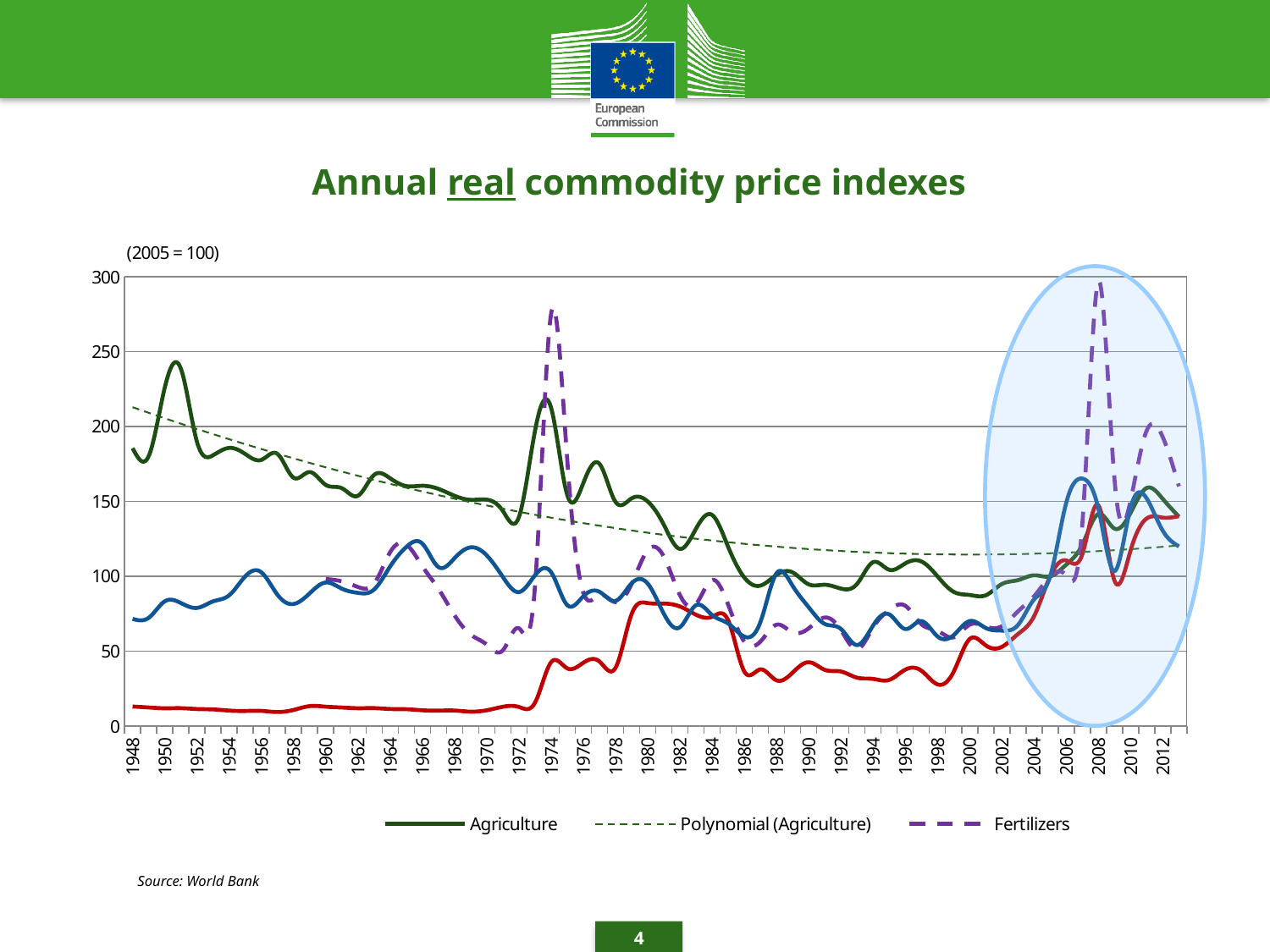
In which year does the Fertilizers series reach its highest value? 2008 Is the value for Fertilizers in 1974 greater or less than 250? greater Is the value for Fertilizers in 1992 greater or less than 100? less Does the Polynomial (Agriculture) line rise or fall between 1948 and 2000? fall Is the value for Fertilizers in 2008 greater or less than 250? greater What kind of chart is shown on the slide? line chart Which year is used as the base year (index = 100) for the chart? 2005 What is the title of the chart? Annual real commodity price indexes How many series does the legend list? 3